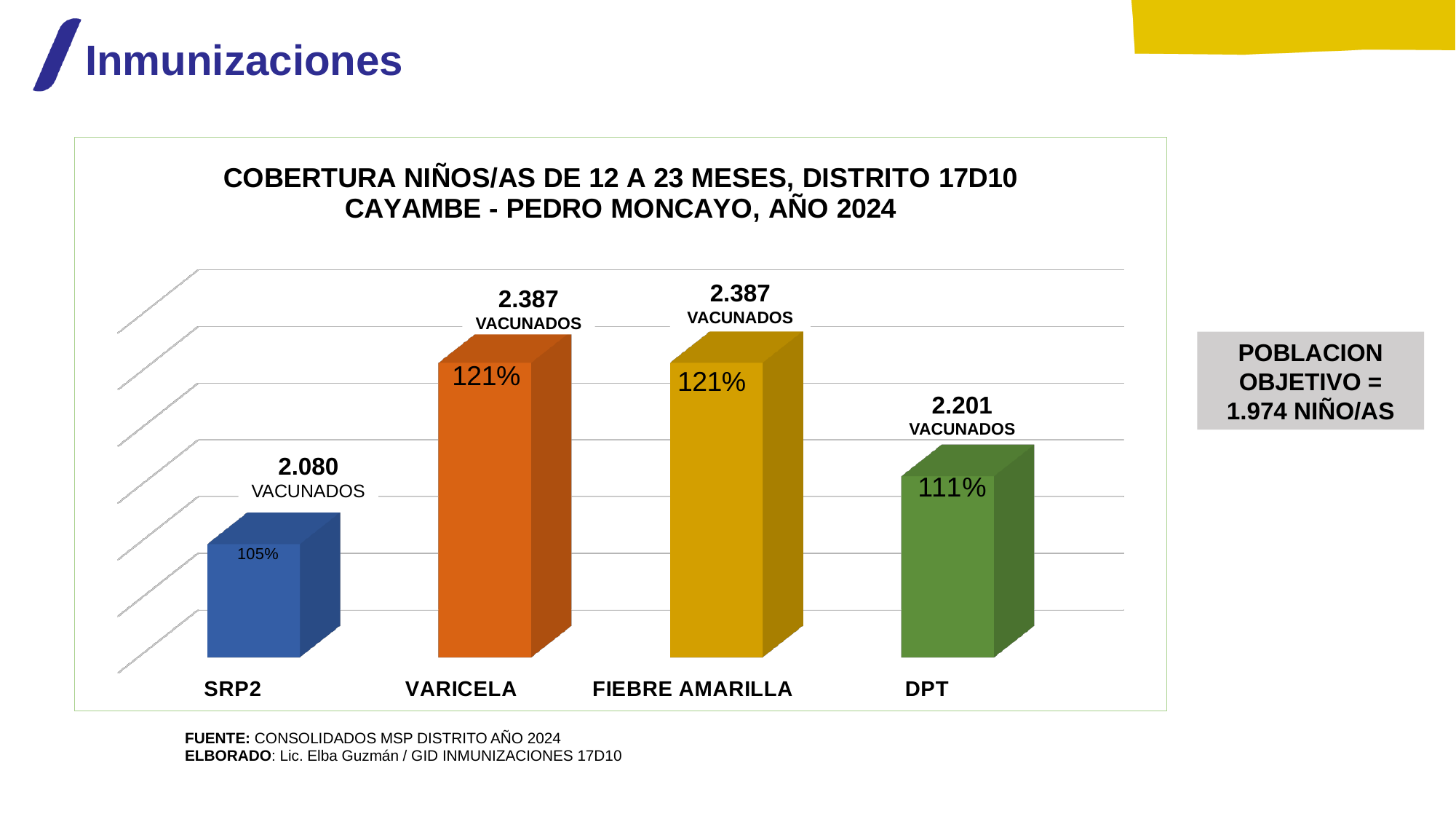
Which has a higher number of vaccinated children, SRP2 or DPT? DPT How many vaccinated children are reported for DPT? 2.201 VACUNADOS How many vaccine categories are shown in the chart? 4 What coverage percentage is shown for DPT? 111% Which has a higher coverage percentage, VARICELA or DPT? VARICELA What coverage percentage is shown for FIEBRE AMARILLA? 121% Which vaccine has the lowest coverage percentage? SRP2 What type of chart is shown on the slide? Bar chart How many vaccinated children are reported for VARICELA? 2.387 VACUNADOS What is the difference in coverage percentage between DPT and SRP2? 6 percentage points What is the target population (POBLACION OBJETIVO) stated next to the chart? 1.974 NIÑO/AS What coverage percentage is shown for SRP2? 105%